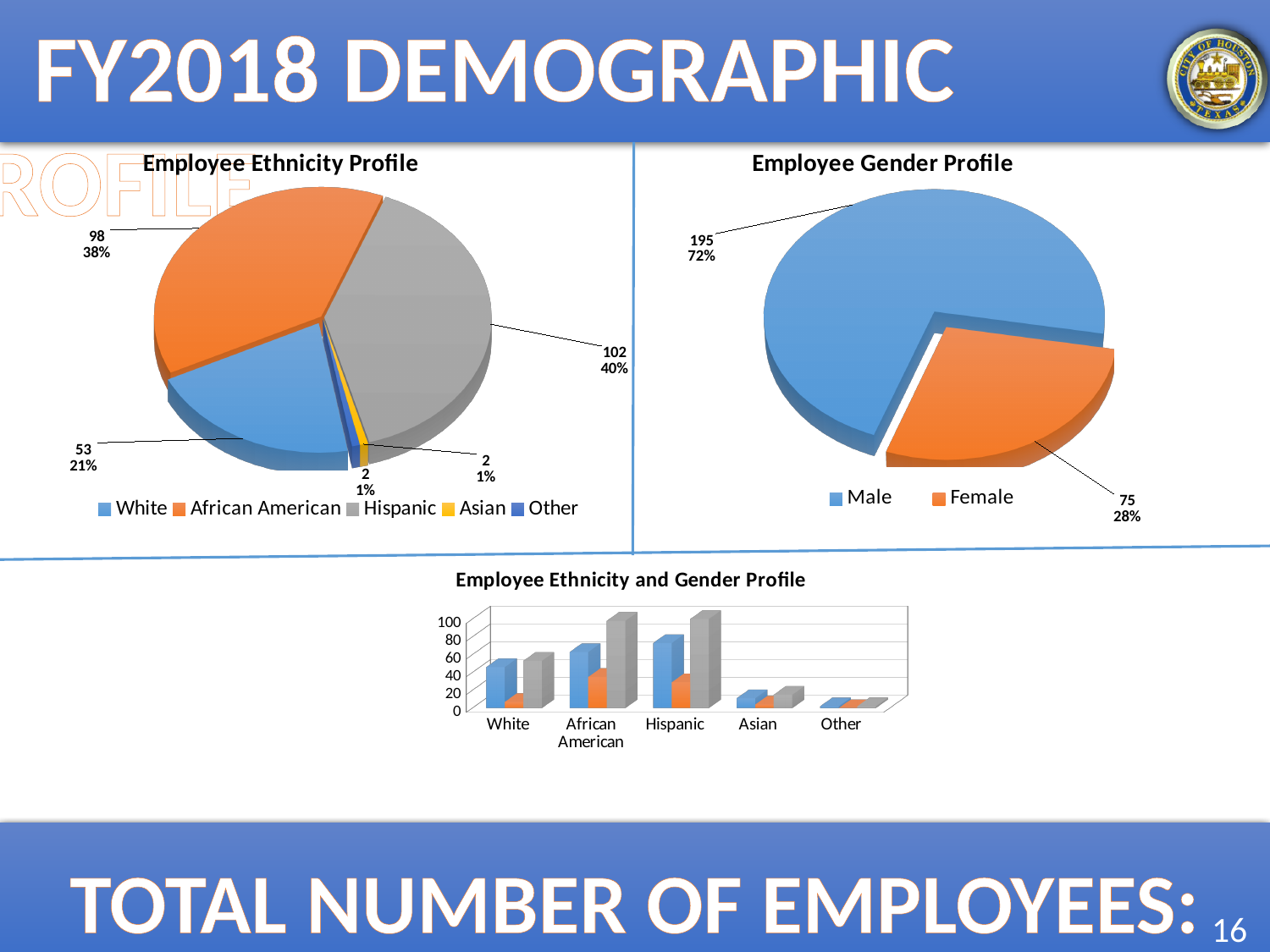
In the Employee Ethnicity Profile chart, which is larger, the White slice or the African American slice? African American What kind of chart is the Employee Gender Profile chart? Pie chart How many categories are shown on the x axis of the Employee Ethnicity and Gender Profile chart? 5 How many categories does the Employee Ethnicity Profile chart's legend list? 5 In the Employee Ethnicity Profile chart, what is the difference between the number of Hispanic and White employees? 49 In the Employee Gender Profile chart, what is the difference between the number of Male and Female employees? 120 In the Employee Ethnicity Profile chart, which ethnicity has the largest share? Hispanic What kind of chart is the Employee Ethnicity and Gender Profile chart at the bottom of the slide? Bar chart In the Employee Ethnicity Profile chart, how many employees are Hispanic? 102 In the Employee Ethnicity Profile chart, what percentage of employees are African American? 38% In the Employee Gender Profile chart, how many employees are Male? 195 In the Employee Gender Profile chart, what share of employees are Female? 28%